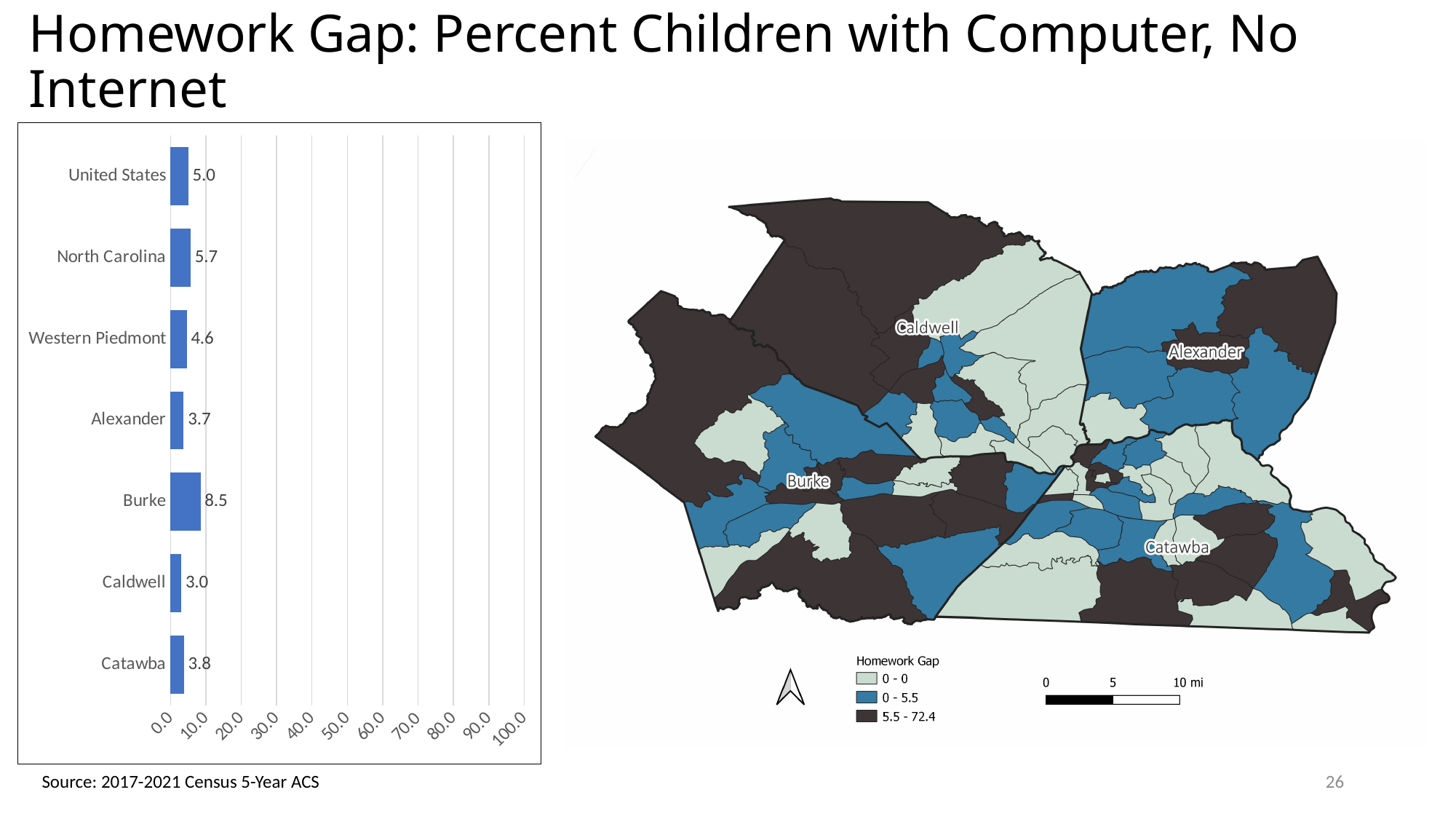
What is the difference between the values for North Carolina and the United States in the bar chart? 0.7 Which category has the highest value in the bar chart? Burke What is the value for Caldwell in the bar chart? 3.0 What is the highest value shown on the x axis of the bar chart? 100.0 Which category has the lowest value in the bar chart? Caldwell What is the value for Burke in the bar chart? 8.5 How many categories are shown in the bar chart? 7 Is the value for Burke in the bar chart greater or less than 10.0? less What kind of chart is shown on the left of the slide? bar chart Which is larger in the bar chart, the value for Alexander or the value for Catawba? Catawba What is the difference between the values for Burke and Caldwell in the bar chart? 5.5 What is the value for North Carolina in the bar chart? 5.7